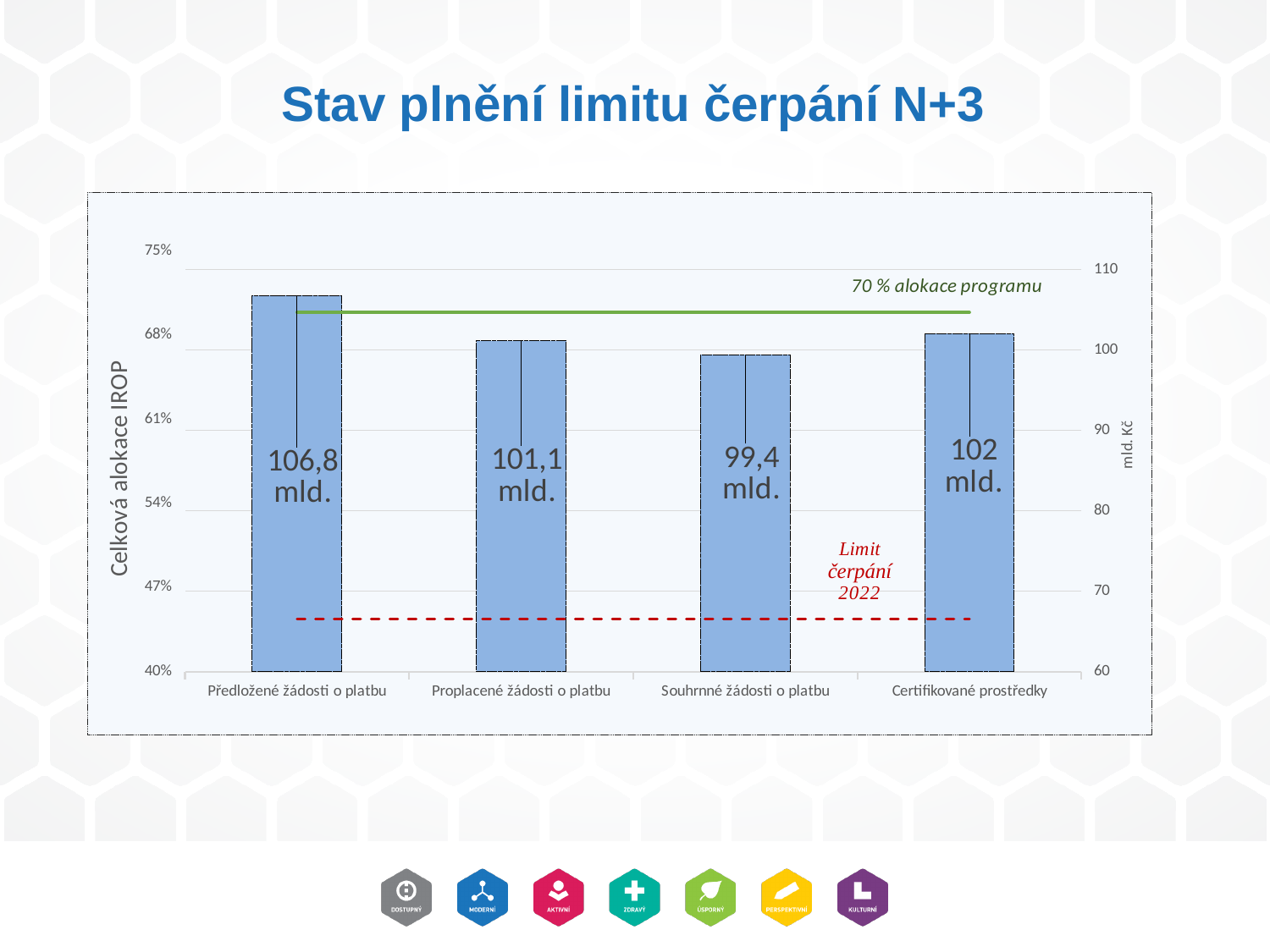
What is the difference between the values for Předložené žádosti o platbu and Souhrnné žádosti o platbu? 7,4 mld. What is the title of the slide containing the chart? Stav plnění limitu čerpání N+3 What kind of chart is shown on the slide? Combination bar and line chart What does the green horizontal line in the chart represent? 70 % alokace programu What is the value shown for Předložené žádosti o platbu? 106,8 mld. Which category has the highest value? Předložené žádosti o platbu What is the value shown for Souhrnné žádosti o platbu? 99,4 mld. What is the value shown for Certifikované prostředky? 102 mld. Which is larger, the value for Certifikované prostředky or the value for Proplacené žádosti o platbu? Certifikované prostředky Which category has the lowest value? Souhrnné žádosti o platbu How many categories are shown on the x axis? 4 What is the value shown for Proplacené žádosti o platbu? 101,1 mld.